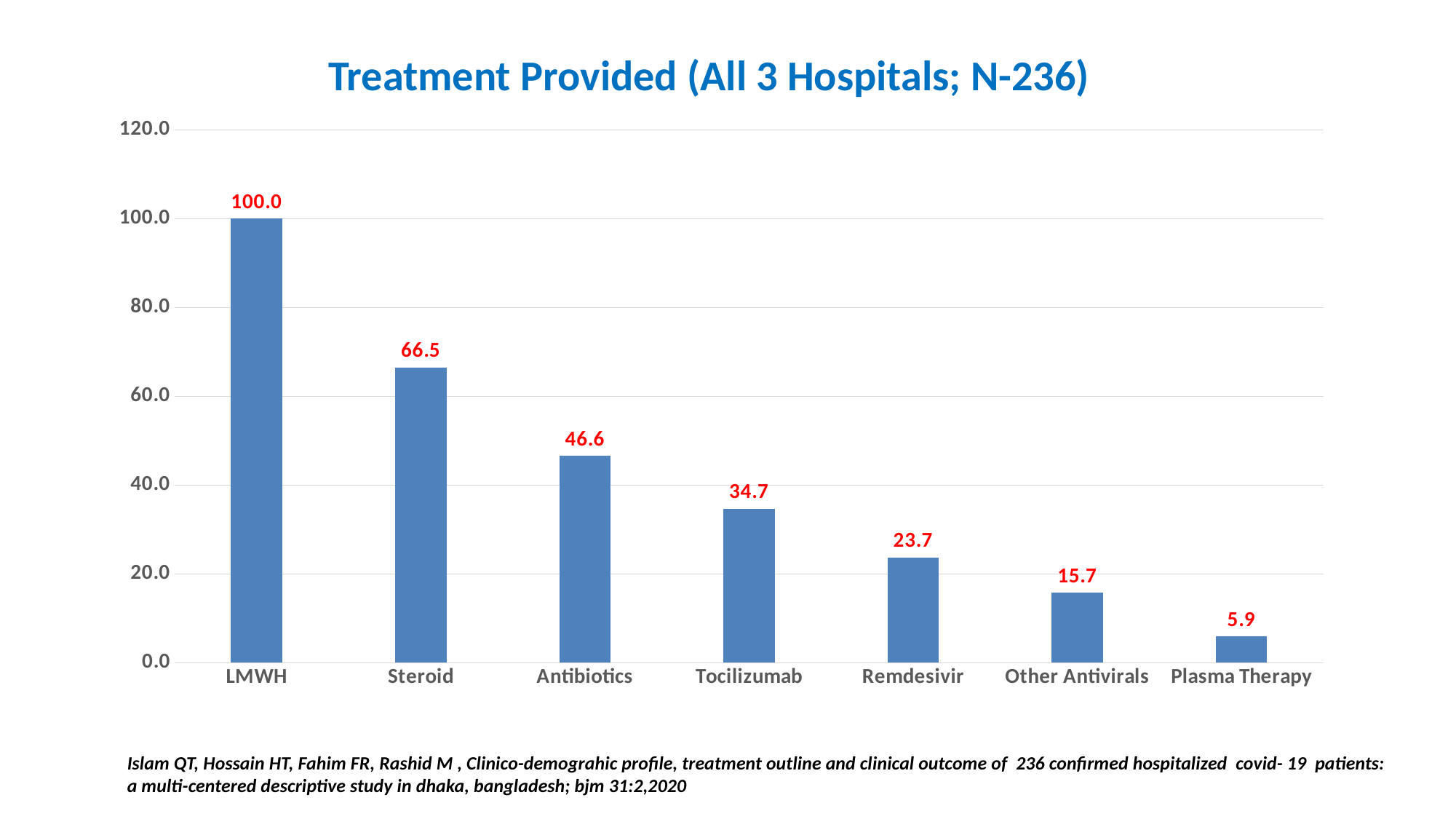
What is the difference between the values for Antibiotics and Remdesivir? 22.9 How many treatment categories are shown in the chart? 7 Which is larger, the value for Remdesivir or the value for Other Antivirals? Remdesivir What kind of chart is shown on the slide? Bar chart What is the value for Steroid? 66.5 Which treatment has the lowest value? Plasma Therapy What is the difference between the values for LMWH and Steroid? 33.5 Which treatment has the highest value? LMWH What is the title of the chart? Treatment Provided (All 3 Hospitals; N-236) What is the value for Tocilizumab? 34.7 What is the value for Plasma Therapy? 5.9 Is the value for Antibiotics greater or less than 40.0? greater